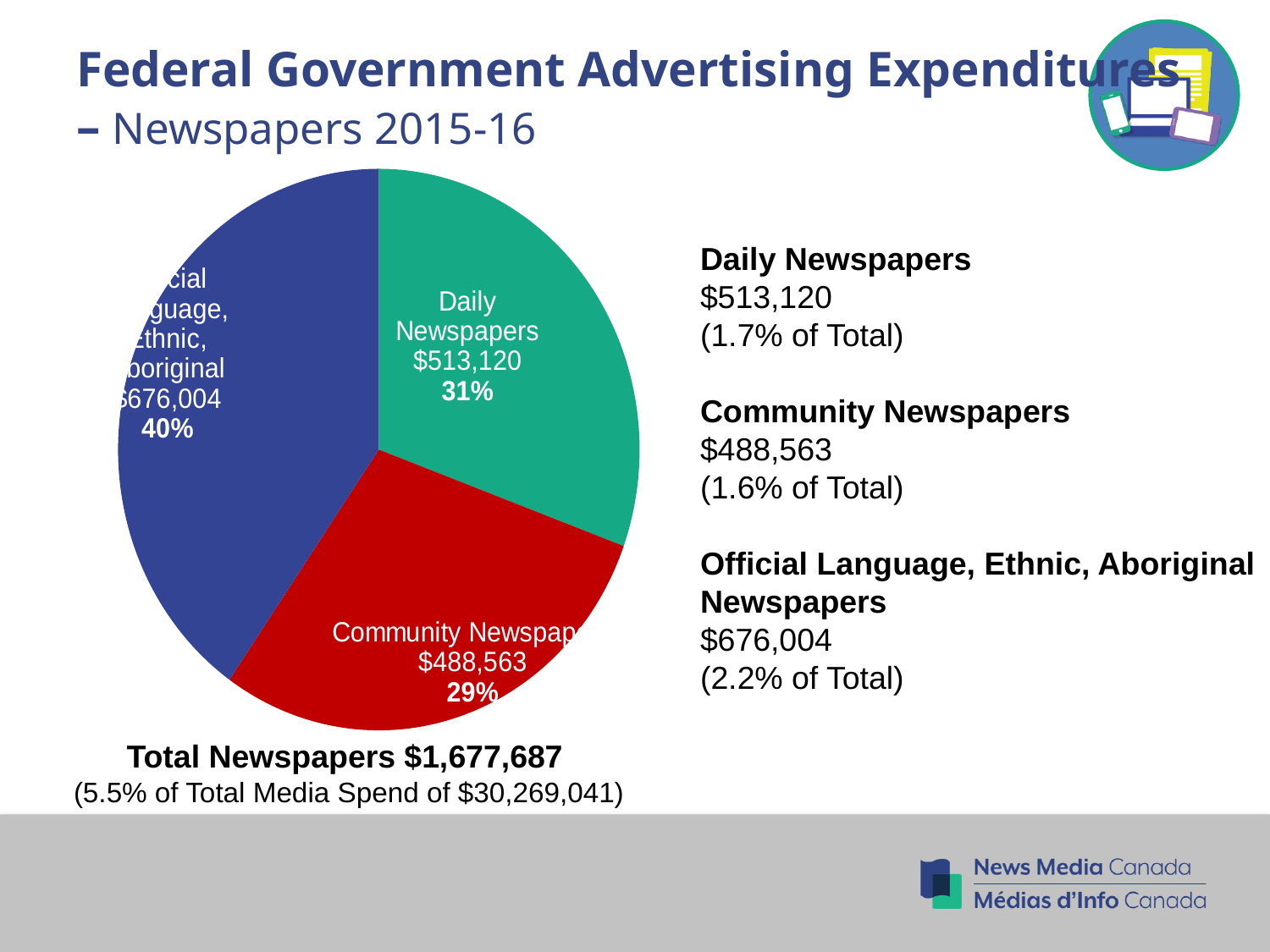
What kind of chart is shown on the slide? Pie chart What is the difference between the Official Language, Ethnic, Aboriginal Newspapers value and the Daily Newspapers value? $162,884 Which category has the smallest slice of the pie? Community Newspapers How many slices does the pie chart have? 3 What is the value for Official Language, Ethnic, Aboriginal Newspapers? $676,004 What colour is the Community Newspapers slice? Red What is the value for Community Newspapers? $488,563 Which is larger, the value for Daily Newspapers or the value for Community Newspapers? Daily Newspapers What share of the pie does Official Language, Ethnic, Aboriginal Newspapers represent? 40% What is the value for Daily Newspapers? $513,120 What share of the pie does Daily Newspapers represent? 31% Which category has the largest slice of the pie? Official Language, Ethnic, Aboriginal Newspapers